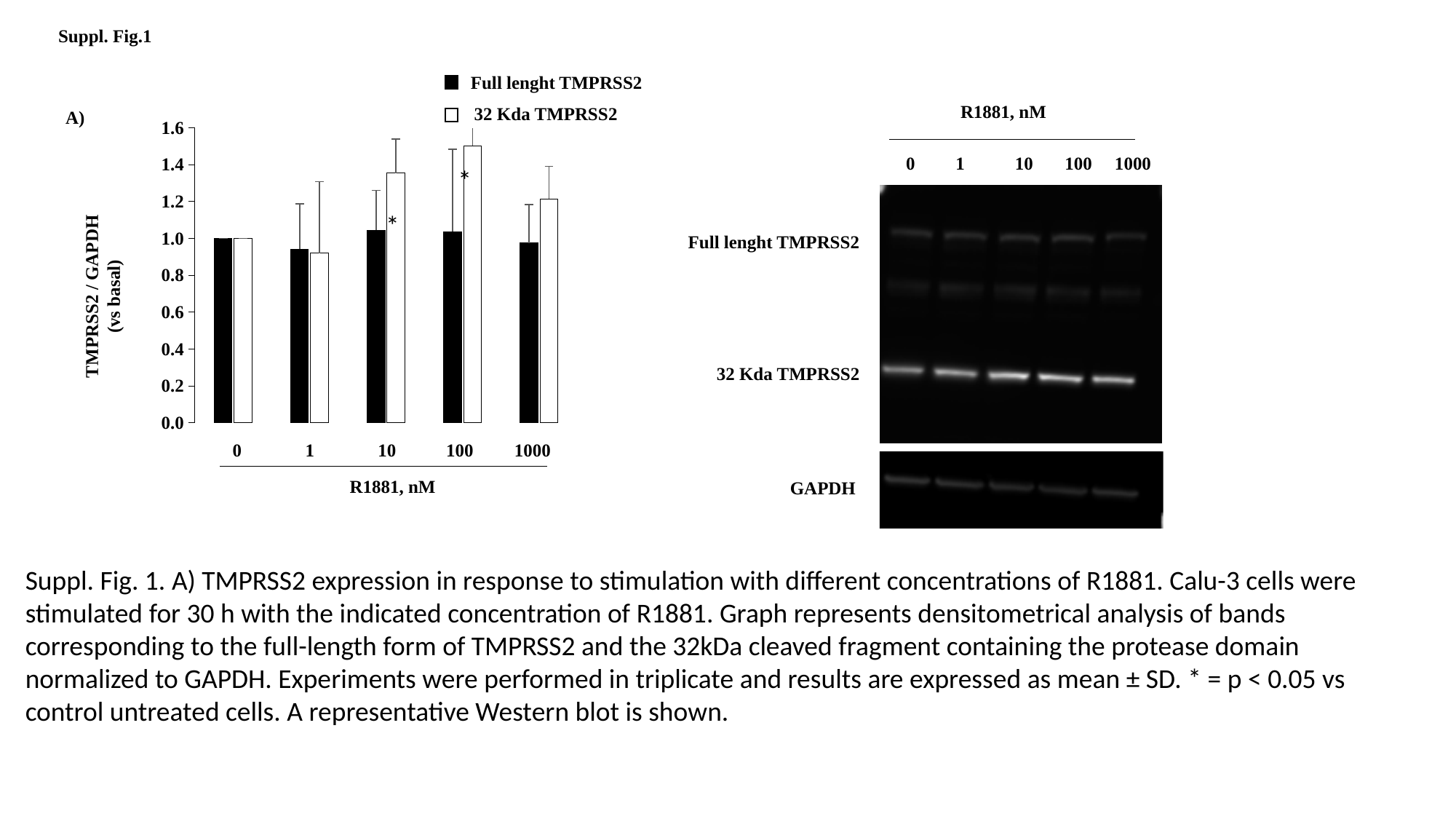
What kind of chart is shown in panel A? bar chart How many R1881 concentrations are plotted on the x axis of the bar chart? 5 How many series does the legend of the bar chart list? 2 What colour are the Full lenght TMPRSS2 bars in the chart? black What is the value of Full lenght TMPRSS2 at 0 nM R1881 in the bar chart? 1.0 What is the x-axis title of the bar chart? R1881, nM Is the value for 32 Kda TMPRSS2 at 100 nM R1881 greater or less than 1.4? greater Is the value for 32 Kda TMPRSS2 at 10 nM R1881 greater or less than 1.2? greater At 100 nM R1881, which series has the larger bar, Full lenght TMPRSS2 or 32 Kda TMPRSS2? 32 Kda TMPRSS2 At which R1881 concentration is the 32 Kda TMPRSS2 bar highest? 100 Is the value for Full lenght TMPRSS2 at 1 nM R1881 greater or less than 1.0? less What is the value of 32 Kda TMPRSS2 at 0 nM R1881 in the bar chart? 1.0